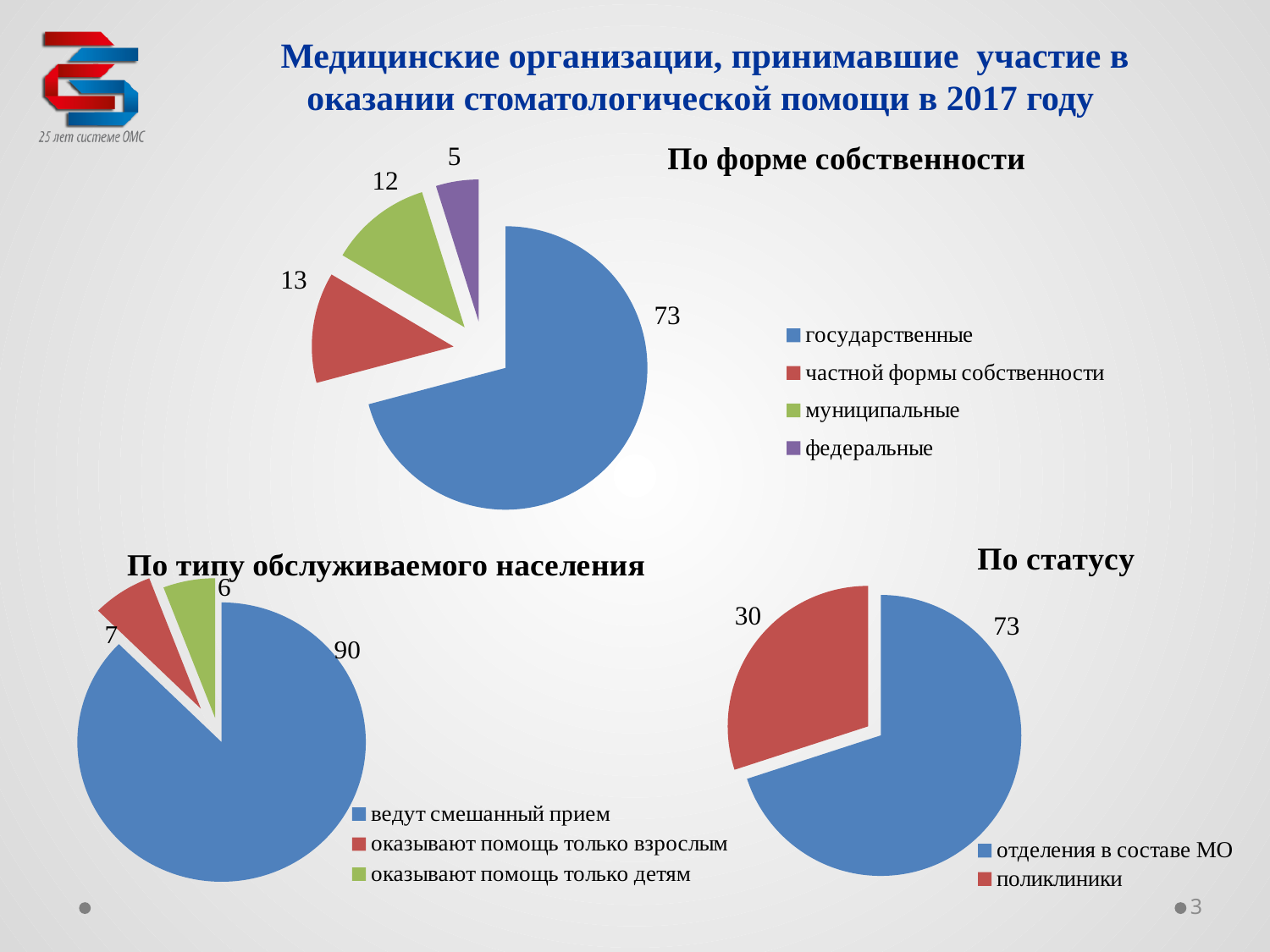
In the chart 'По статусу', what is the difference between отделения в составе МО and поликлиники? 43 In the chart 'По форме собственности', which category has the smallest value? федеральные In the chart 'По форме собственности', how many categories are shown? 4 In the chart 'По форме собственности', what is the difference between частной формы собственности and муниципальные? 1 In the chart 'По типу обслуживаемого населения', which is larger: оказывают помощь только взрослым or оказывают помощь только детям? оказывают помощь только взрослым In the chart 'По статусу', what is the value for поликлиники? 30 In the chart 'По форме собственности', what is the value for федеральные? 5 In the chart 'По статусу', what colour is the slice for поликлиники? red In the chart 'По типу обслуживаемого населения', what is the value for ведут смешанный прием? 90 In the chart 'По форме собственности', what is the value for государственные? 73 In the chart 'По типу обслуживаемого населения', which category has the largest value? ведут смешанный прием What type of chart is 'По статусу'? pie chart